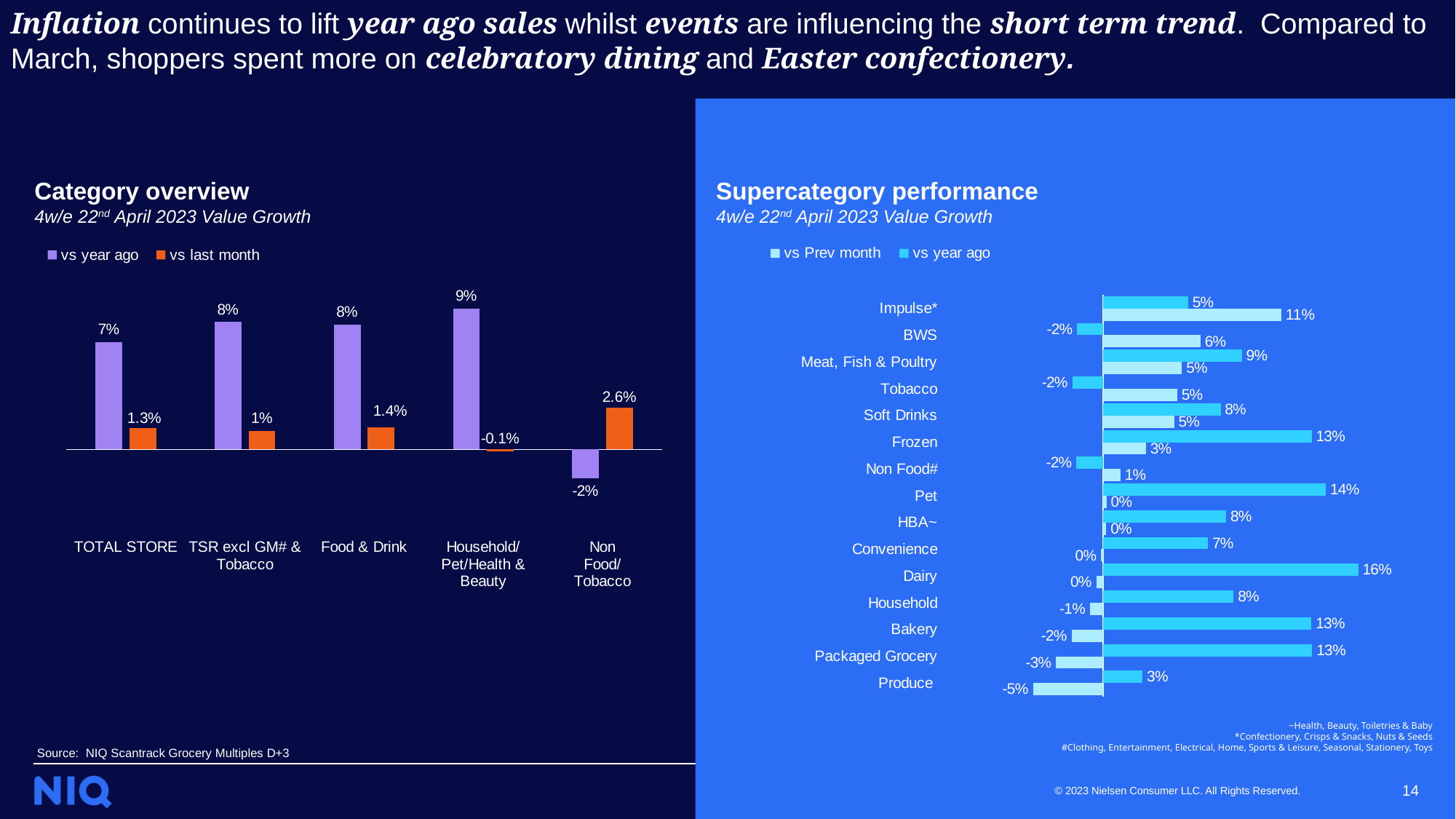
What kind of chart is the Supercategory performance chart? Bar chart On the Category overview chart, what is the difference between the vs last month values for Non Food/Tobacco and TOTAL STORE? 1.3% On the Category overview chart, what is the vs year ago value for TOTAL STORE? 7% On the Category overview chart, which category has the lowest vs year ago value? Non Food/Tobacco On the Supercategory performance chart, which supercategory has the lowest value shown? Produce On the Supercategory performance chart, how many supercategories are listed? 15 On the Category overview chart, what is the vs last month value for Household/Pet/Health & Beauty? -0.1% On the Category overview chart, how many series does the legend list? 2 On the Supercategory performance chart, what are the two values shown for Impulse*? 5% and 11% On the Category overview chart, what is the vs last month value for Food & Drink? 1.4% On the Category overview chart, which category has the highest vs year ago value? Household/Pet/Health & Beauty On the Supercategory performance chart, which supercategory has the highest value shown? Dairy